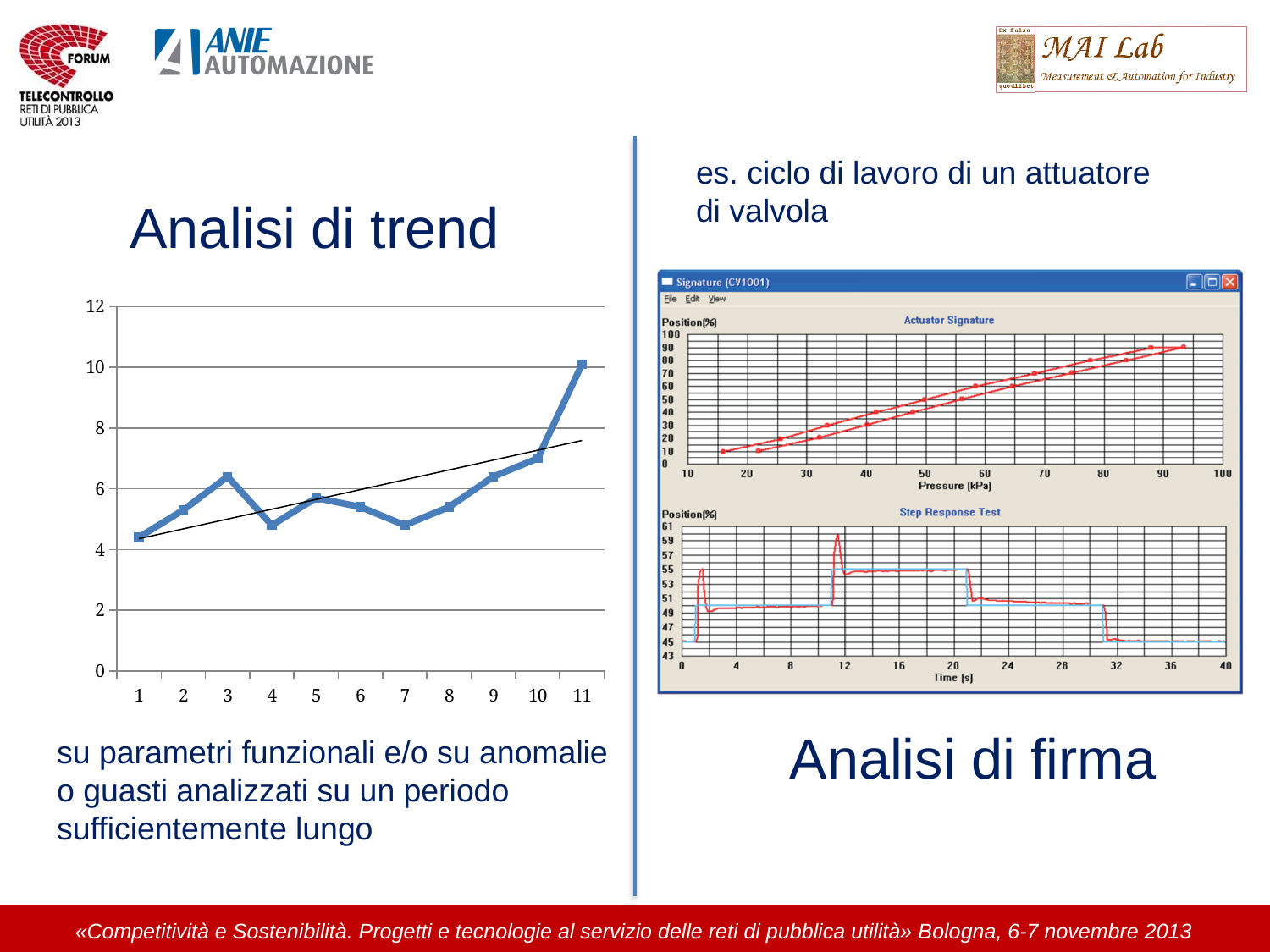
On the 'Analisi di trend' chart, is the value at category 10 greater or less than 6? greater On the 'Analisi di trend' chart, is the value at category 1 greater or less than 6? less In the screenshot on the right, what is the x-axis label of the 'Actuator Signature' chart? Pressure [kPa] How many data points are plotted on the 'Analisi di trend' line chart? 11 On the 'Analisi di trend' chart, do the values overall rise or fall from category 1 to category 11? rise On the 'Analisi di trend' chart, which x-axis category has the highest value? 11 On the 'Analisi di trend' chart, which has the larger value, category 3 or category 4? 3 What kind of chart is the 'Analisi di trend' chart on the left of the slide? line chart On the 'Analisi di trend' chart, is the value at category 11 greater or less than 8? greater On the 'Analisi di trend' chart, which has the larger value, category 1 or category 11? 11 What is the maximum value shown on the y axis of the 'Analisi di trend' chart? 12